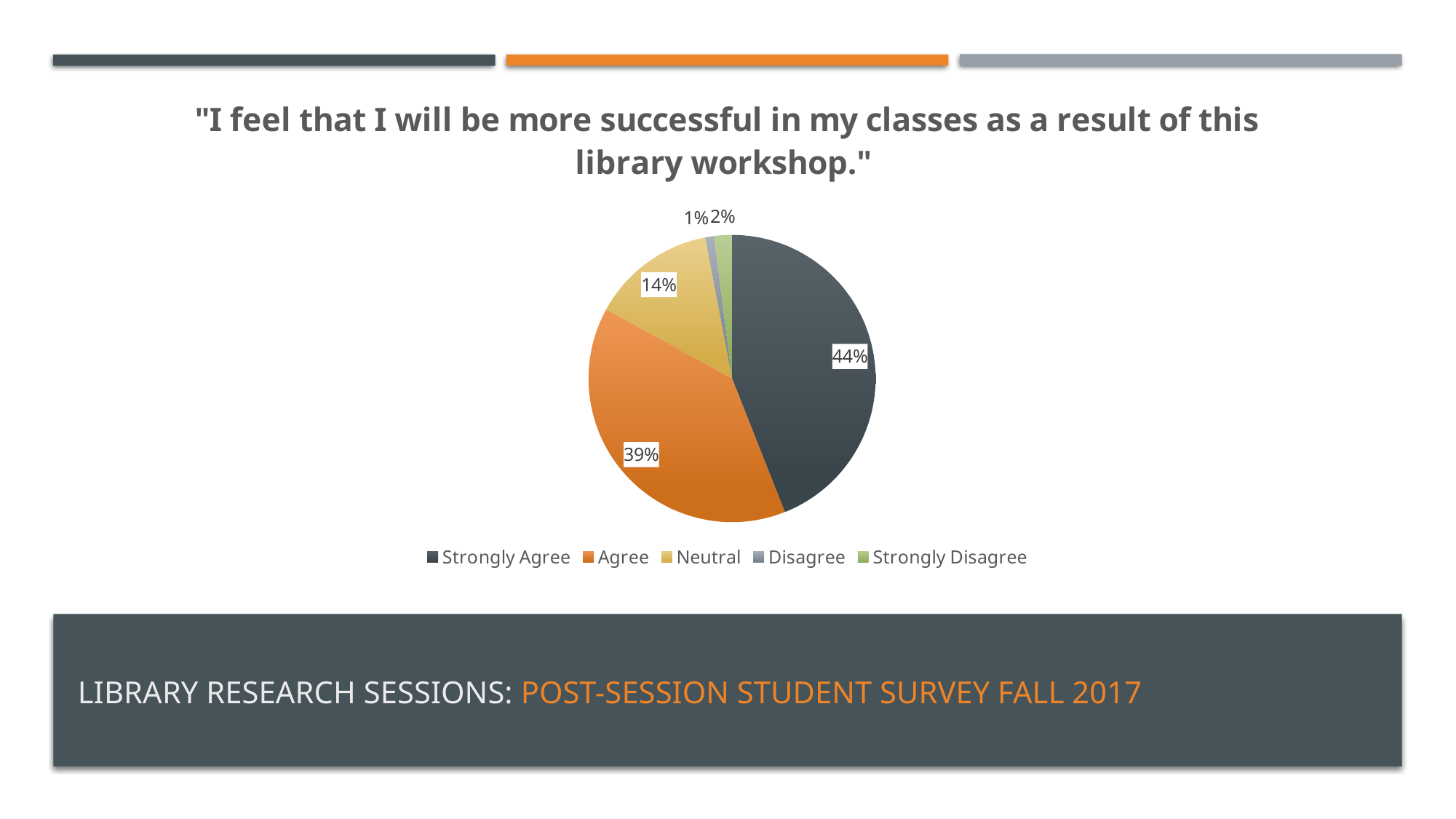
What kind of chart is shown on the slide? pie chart Which is larger, the Agree slice or the Neutral slice? Agree Which response category has the smallest slice of the pie? Disagree What is the combined share of Strongly Agree and Agree? 83% How many response categories does the legend list? 5 What share of respondents answered Strongly Agree? 44% What is the difference in percentage points between Agree and Neutral? 25% What is the difference in percentage points between Strongly Agree and Agree? 5% What share of respondents answered Agree? 39% What share of respondents answered Neutral? 14% What colour is the Agree slice in the pie chart? orange Which response category has the largest slice of the pie? Strongly Agree